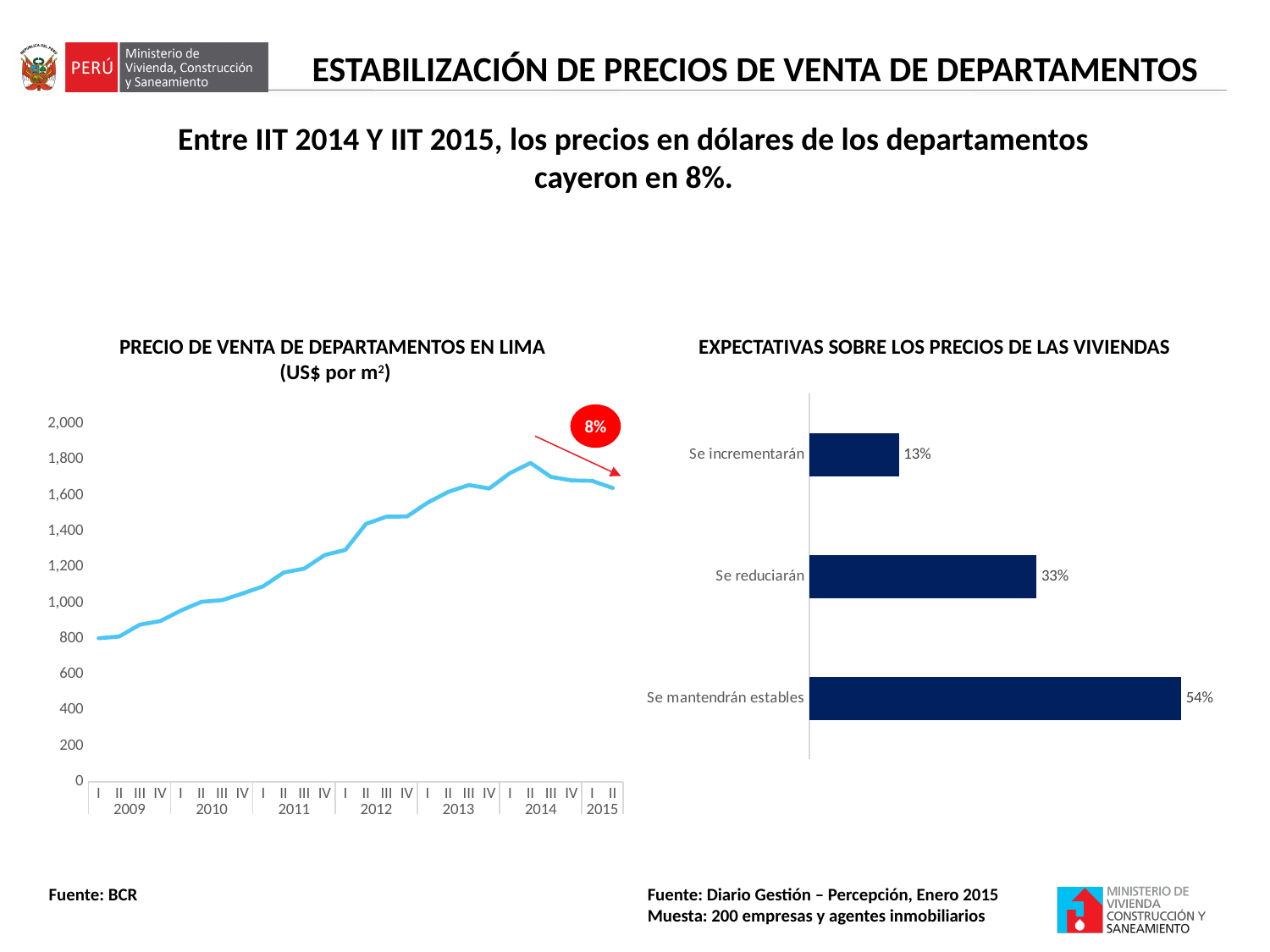
In the chart 'EXPECTATIVAS SOBRE LOS PRECIOS DE LAS VIVIENDAS', what is the value for 'Se mantendrán estables'? 54% In the chart 'EXPECTATIVAS SOBRE LOS PRECIOS DE LAS VIVIENDAS', which category has the lowest value? Se incrementarán In the chart 'EXPECTATIVAS SOBRE LOS PRECIOS DE LAS VIVIENDAS', what is the difference between 'Se mantendrán estables' and 'Se reduciarán'? 21% In the chart 'PRECIO DE VENTA DE DEPARTAMENTOS EN LIMA', is the highest value on the line greater or less than 2,000? less What kind of chart is 'PRECIO DE VENTA DE DEPARTAMENTOS EN LIMA'? line chart What kind of chart is 'EXPECTATIVAS SOBRE LOS PRECIOS DE LAS VIVIENDAS'? bar chart In the chart 'EXPECTATIVAS SOBRE LOS PRECIOS DE LAS VIVIENDAS', which category has the highest value? Se mantendrán estables In the chart 'EXPECTATIVAS SOBRE LOS PRECIOS DE LAS VIVIENDAS', how many categories are shown? 3 In the chart 'PRECIO DE VENTA DE DEPARTAMENTOS EN LIMA', is the value for quarter I of 2013 greater or less than 1,400? greater In the chart 'EXPECTATIVAS SOBRE LOS PRECIOS DE LAS VIVIENDAS', what is the value for 'Se incrementarán'? 13% In the chart 'PRECIO DE VENTA DE DEPARTAMENTOS EN LIMA', do the values generally rise or fall from 2009 to 2014? rise In the chart 'EXPECTATIVAS SOBRE LOS PRECIOS DE LAS VIVIENDAS', what is the value for 'Se reduciarán'? 33%